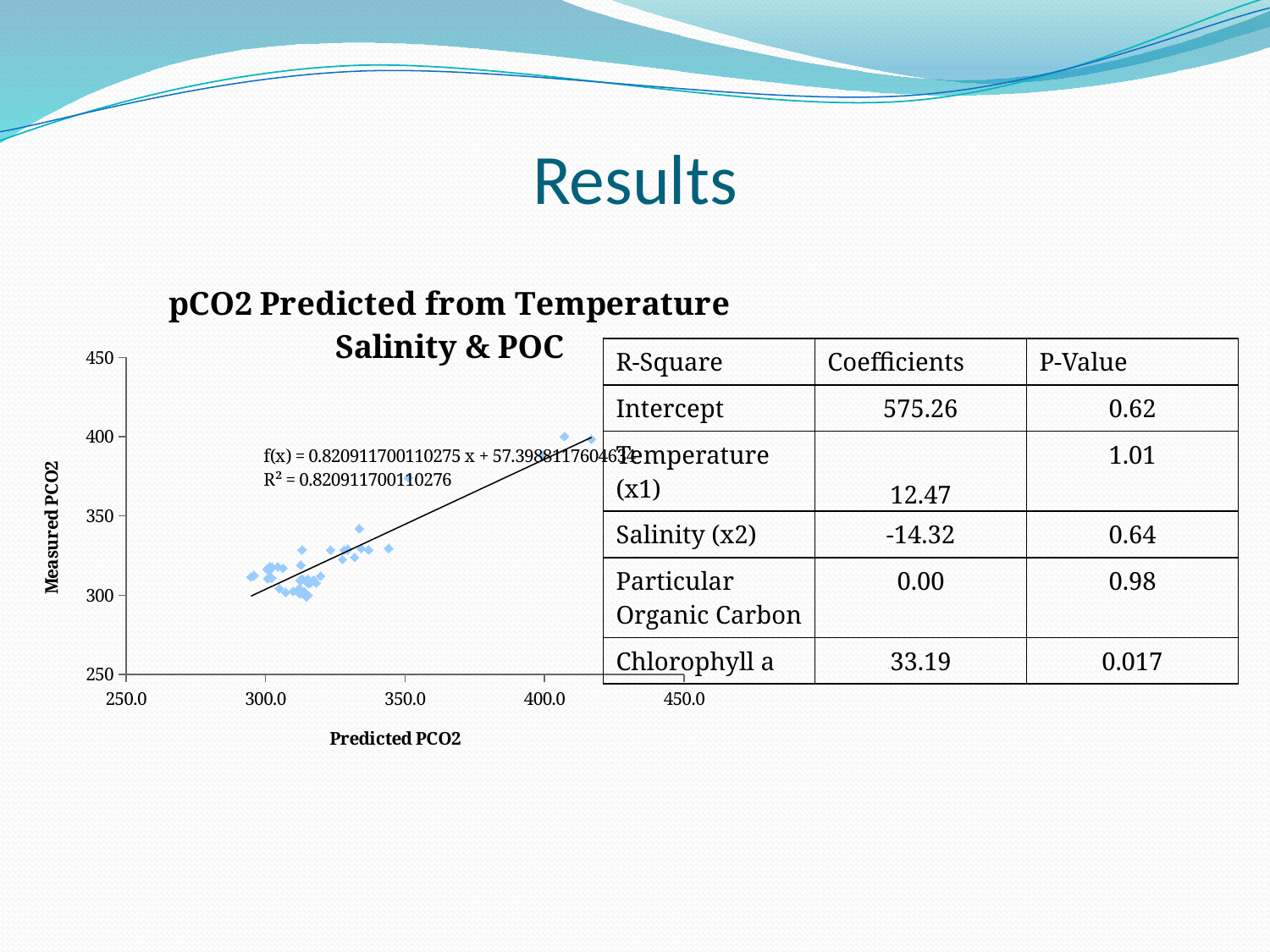
Is the measured PCO2 value of the leftmost point on the chart greater or less than 300? greater Is the measured PCO2 value of the highest point on the chart greater or less than 350? greater What kind of chart is shown on the slide? scatter chart What is the title of the chart? pCO2 Predicted from Temperature Salinity & POC What is the label of the x axis of the chart? Predicted PCO2 What R² value is printed on the chart for the trendline? 0.820911700110276 Which has a higher measured PCO2: the rightmost point or the leftmost point on the chart? the rightmost point Are the predicted PCO2 values of the two rightmost points greater or less than 400.0? greater Do the measured PCO2 values rise or fall as predicted PCO2 increases along the x axis? rise What is the slope of the trendline equation printed on the chart? 0.820911700110275